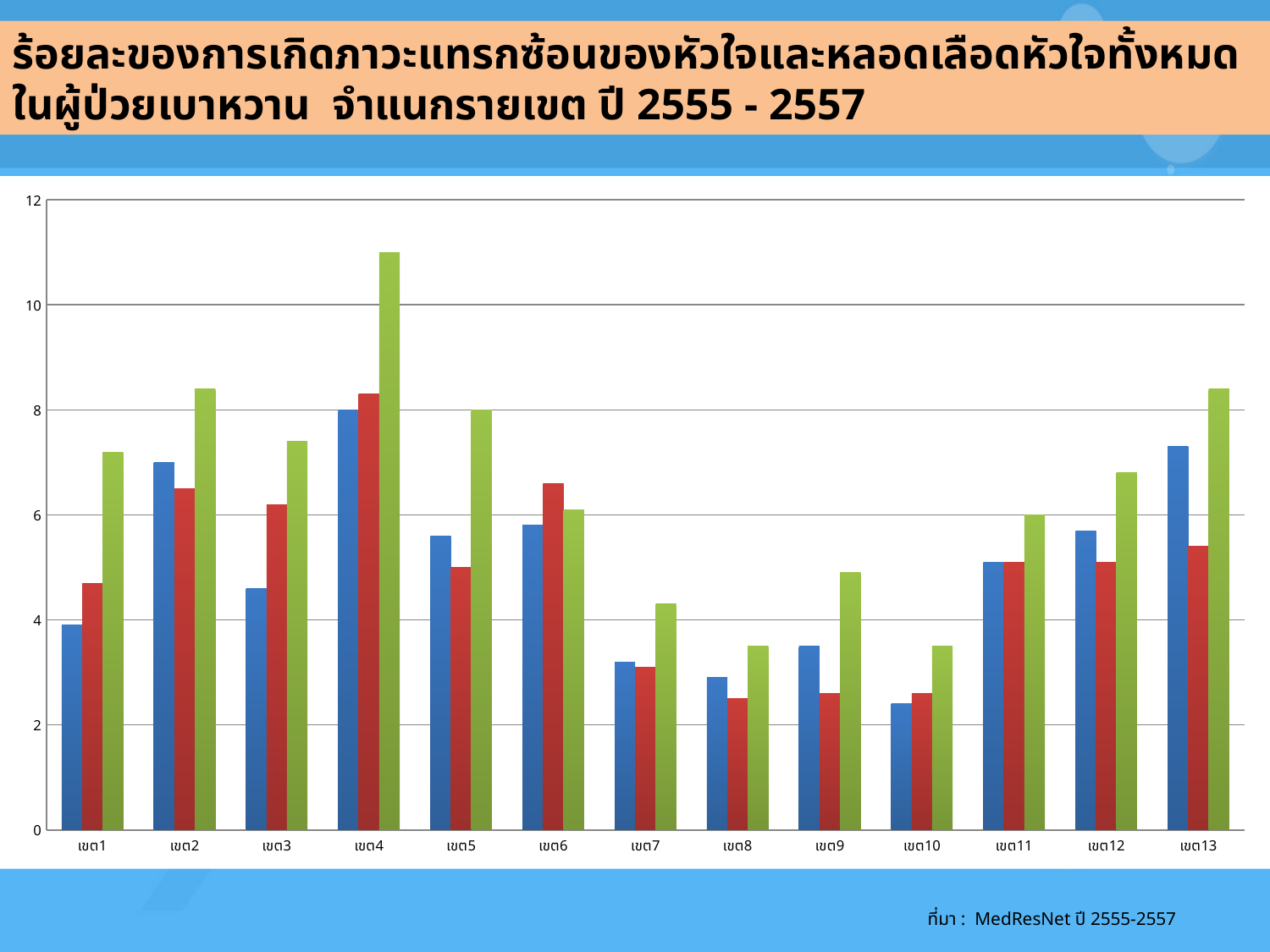
Which เขต has the tallest green bar? เขต4 What is the source cited at the bottom of the slide? MedResNet ปี 2555-2557 Which is larger, the green bar for เขต4 or the green bar for เขต2? เขต4 Is the value of the blue bar for เขต13 greater or less than 6? greater Which เขต has the shortest blue bar? เขต10 How many เขต categories are shown along the x axis? 13 Which เขต has the tallest bar on the chart? เขต4 Is the value of the red bar for เขต8 greater or less than 4? less Is the value of the blue bar for เขต10 greater or less than 4? less What kind of chart is shown on the slide? bar chart Which is larger for เขต6, the blue bar or the red bar? the red bar